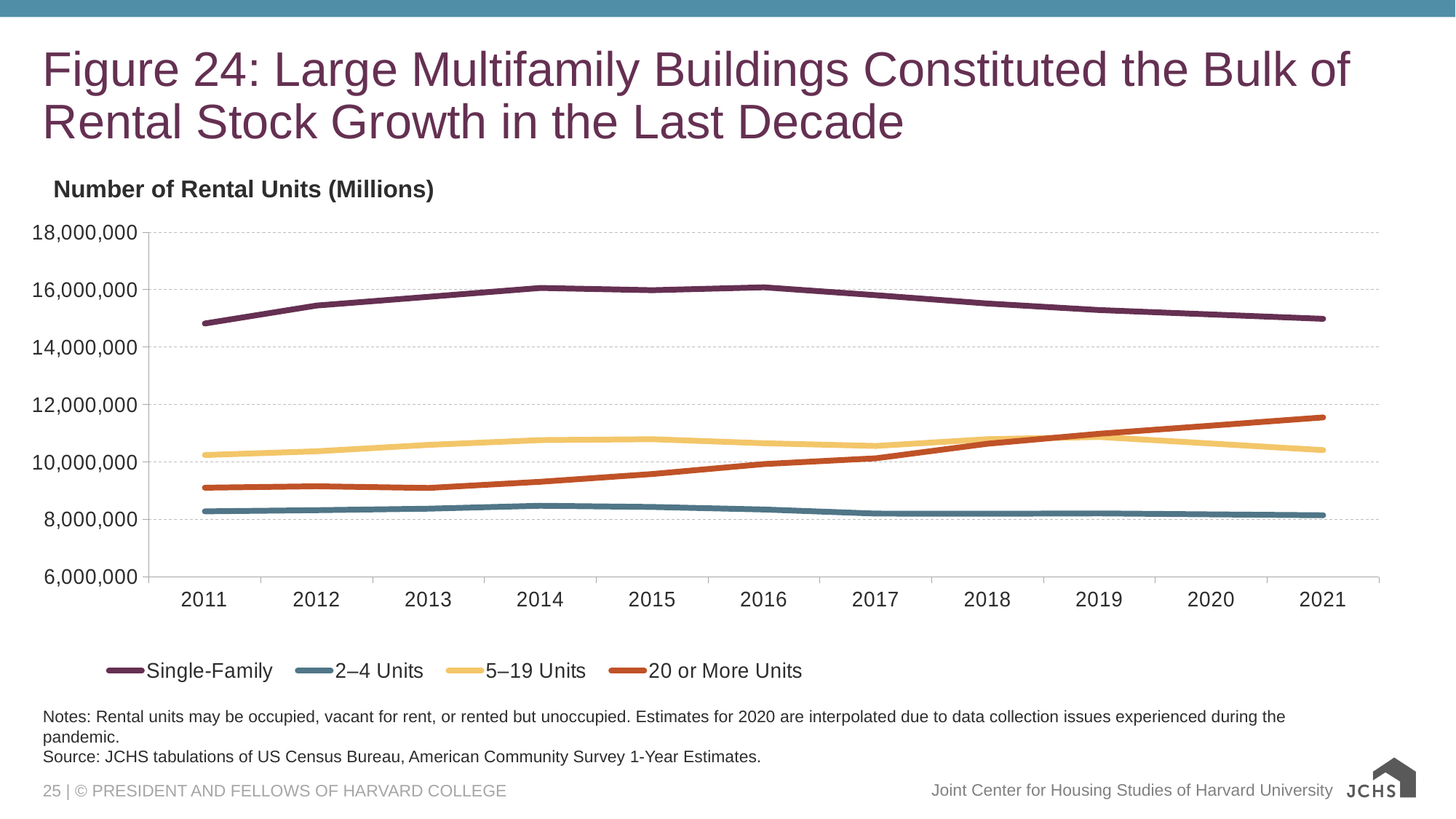
Which series has the highest value in 2021? Single-Family Is the value for 20 or More Units in 2021 greater or less than 10,000,000? greater Is the value for Single-Family in 2011 greater or less than 14,000,000? greater Does the Single-Family line rise or fall from 2016 to 2021? fall What type of chart is shown on the slide? line chart Is the value for 20 or More Units in 2011 greater or less than 10,000,000? less Does the 20 or More Units line rise or fall from 2011 to 2021? rise How many series does the legend list? 4 How many years are plotted along the x axis? 11 In 2021, which is larger: 20 or More Units or 5–19 Units? 20 or More Units Which series has the lowest value in 2021? 2–4 Units